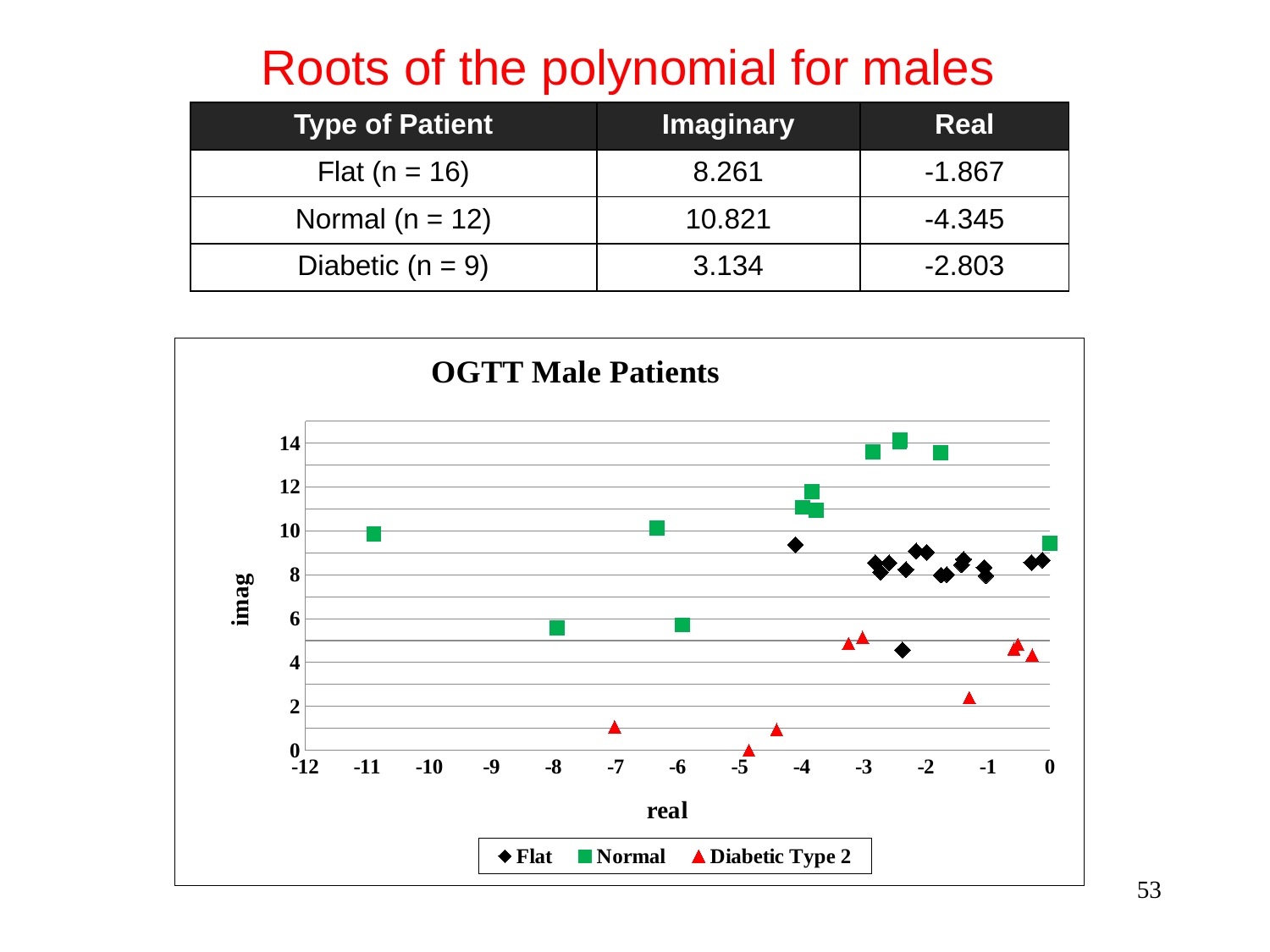
Which series contains the point with the smallest (leftmost) real value? Normal Which series has points with higher imag values overall, Normal or Diabetic Type 2? Normal What kind of chart is shown on the slide? scatter chart How many series does the legend of the OGTT Male Patients chart list? 3 Is the imag value of the Normal point at real ≈ -8 greater or less than 8? less What are the legend entries of the OGTT Male Patients chart? Flat, Normal, Diabetic Type 2 What is the title of the chart on the slide? OGTT Male Patients Which series contains the point with the highest imag value? Normal Which series contains the point with the lowest imag value? Diabetic Type 2 Is the imag value of the Normal point at real ≈ -11 greater or less than 8? greater Is the imag value of the lowest Flat point (at real ≈ -2.4) greater or less than 6? less